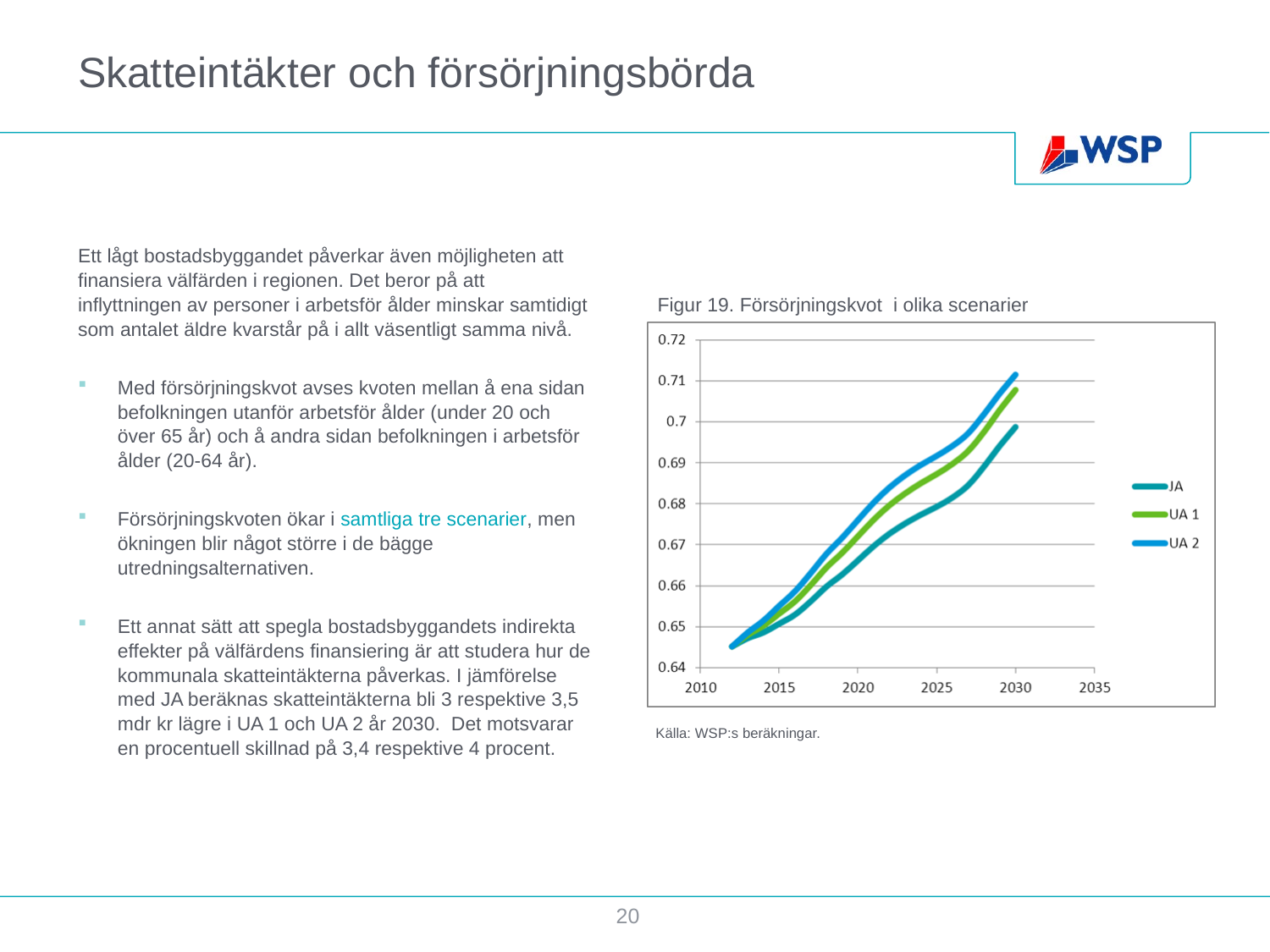
Do the values in Figur 19 rise or fall from 2012 to 2030? rise Which series has the lowest value in 2030 in Figur 19? JA Which series has the highest value in 2030 in Figur 19? UA 2 In Figur 19, is the value for JA in 2030 greater or less than 0.69? greater What kind of chart is shown in Figur 19? line chart In Figur 19, which is larger in 2030: the value for UA 2 or the value for JA? UA 2 How many series does the legend of Figur 19 list? 3 What is the title of the chart on the slide? Figur 19. Försörjningskvot i olika scenarier In Figur 19, is the value for UA 2 in 2030 greater or less than 0.70? greater In Figur 19, is the value for JA in 2020 greater or less than 0.67? less Which series are listed in the legend of Figur 19? JA, UA 1, UA 2